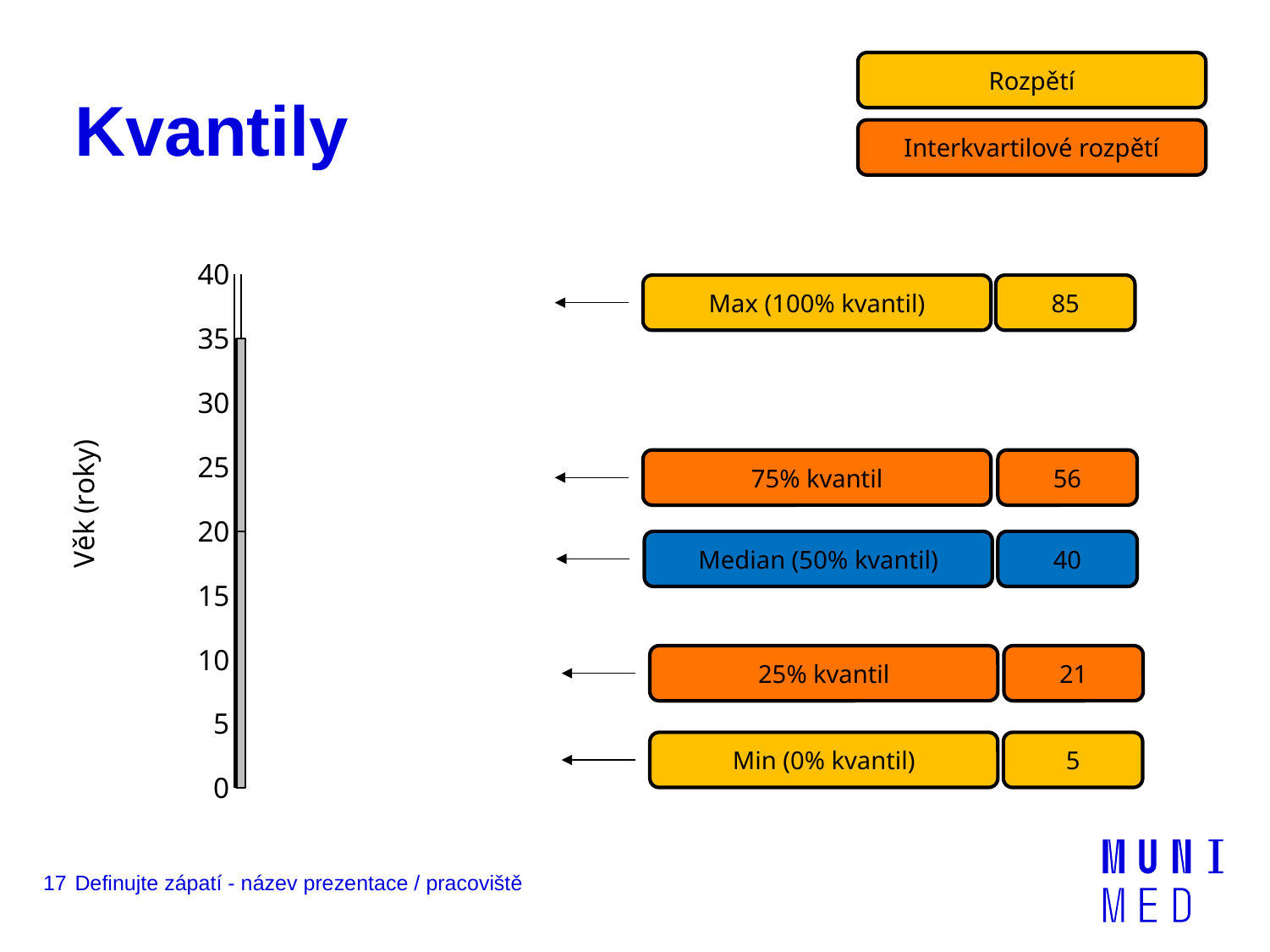
Which is larger, the Median (50% kvantil) value or the 25% kvantil value? Median (50% kvantil) What value is shown for the 25% kvantil? 21 What value is shown for Max (100% kvantil)? 85 What value is shown for the 75% kvantil? 56 What value is shown for Min (0% kvantil)? 5 What is the difference between the 75% kvantil and the 25% kvantil values? 35 What value is shown for Median (50% kvantil)? 40 What is the label of the vertical axis? Věk (roky) Which labelled quantile has the lowest value? Min (0% kvantil) What is the difference between the Max (100% kvantil) and Min (0% kvantil) values? 80 How many quantile labels with values are shown next to the chart? 5 What is the highest tick value shown on the vertical axis? 40